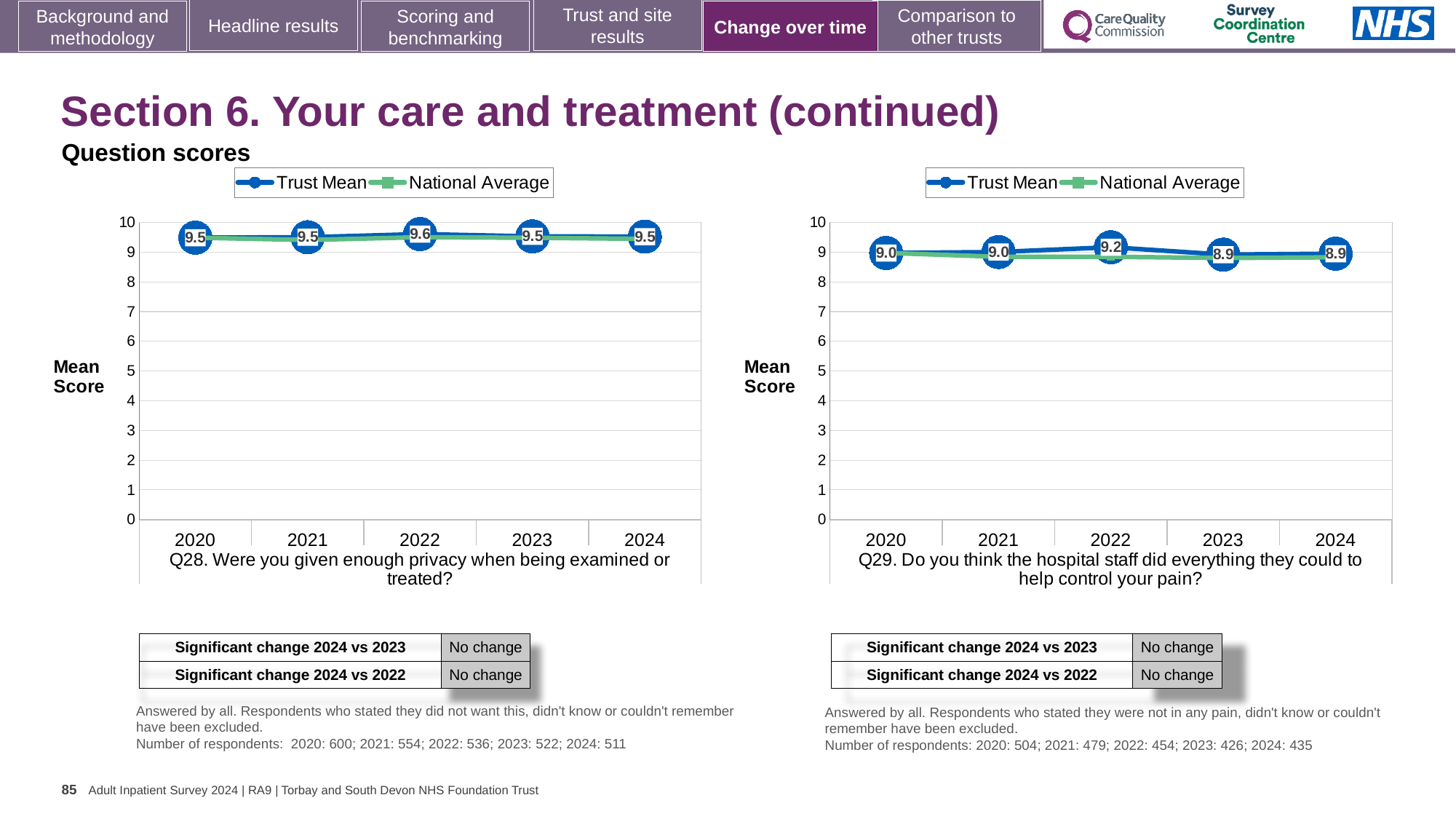
In the Q29 chart (right), what is the Trust Mean score for 2023? 8.9 What kind of chart is the Q28 chart (left)? Line chart How many series does the legend of the Q29 chart (right) list? 2 In the Q29 chart (right), what is the Trust Mean score for 2022? 9.2 In the Q28 chart (left), what is the Trust Mean score for 2022? 9.6 In the Q29 chart (right), is the Trust Mean value for 2020 greater or less than 8? greater In the Q28 chart (left), what is the Trust Mean score for 2024? 9.5 In the Q29 chart (right), what is the difference between the Trust Mean scores for 2022 and 2024? 0.3 How many years are plotted on the x axis of the Q28 chart (left)? 5 In the Q29 chart (right), which year has the highest Trust Mean score? 2022 In the Q28 chart (left), which year has the highest Trust Mean score? 2022 In the Q28 chart (left), is the Trust Mean score for 2021 larger or smaller than the Trust Mean score for 2022? smaller